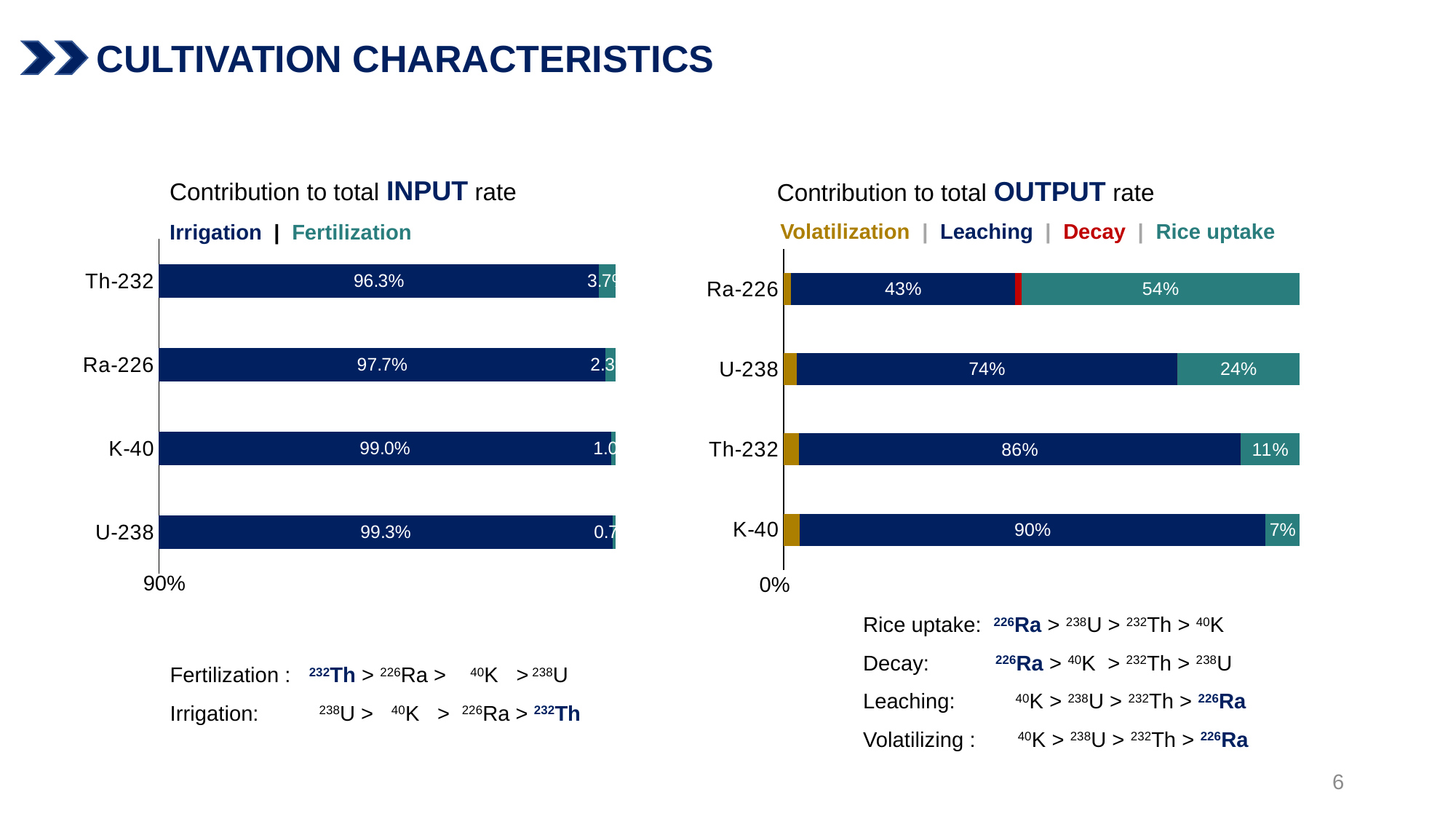
In the 'Contribution to total INPUT rate' chart, what is the Irrigation value for U-238? 99.3% In the 'Contribution to total OUTPUT rate' chart, which has the larger Leaching value, Th-232 or K-40? K-40 How many series does the legend of the 'Contribution to total OUTPUT rate' chart list? 4 In the 'Contribution to total OUTPUT rate' chart, which radionuclide has the highest Rice uptake contribution? Ra-226 In the 'Contribution to total INPUT rate' chart, which radionuclide has the highest Irrigation contribution? U-238 In the 'Contribution to total OUTPUT rate' chart, what is the Rice uptake value for U-238? 24% In the 'Contribution to total OUTPUT rate' chart, what is the Leaching value for Ra-226? 43% What type of chart is the 'Contribution to total INPUT rate' chart? Bar chart In the 'Contribution to total INPUT rate' chart, what is the Irrigation value for Th-232? 96.3% In the 'Contribution to total INPUT rate' chart, how much larger is the Irrigation value for U-238 than for Th-232? 3.0 percentage points In the 'Contribution to total OUTPUT rate' chart, what is the difference between the Rice uptake values for Ra-226 and K-40? 47 percentage points In the 'Contribution to total INPUT rate' chart, which radionuclide has the lowest Irrigation contribution? Th-232